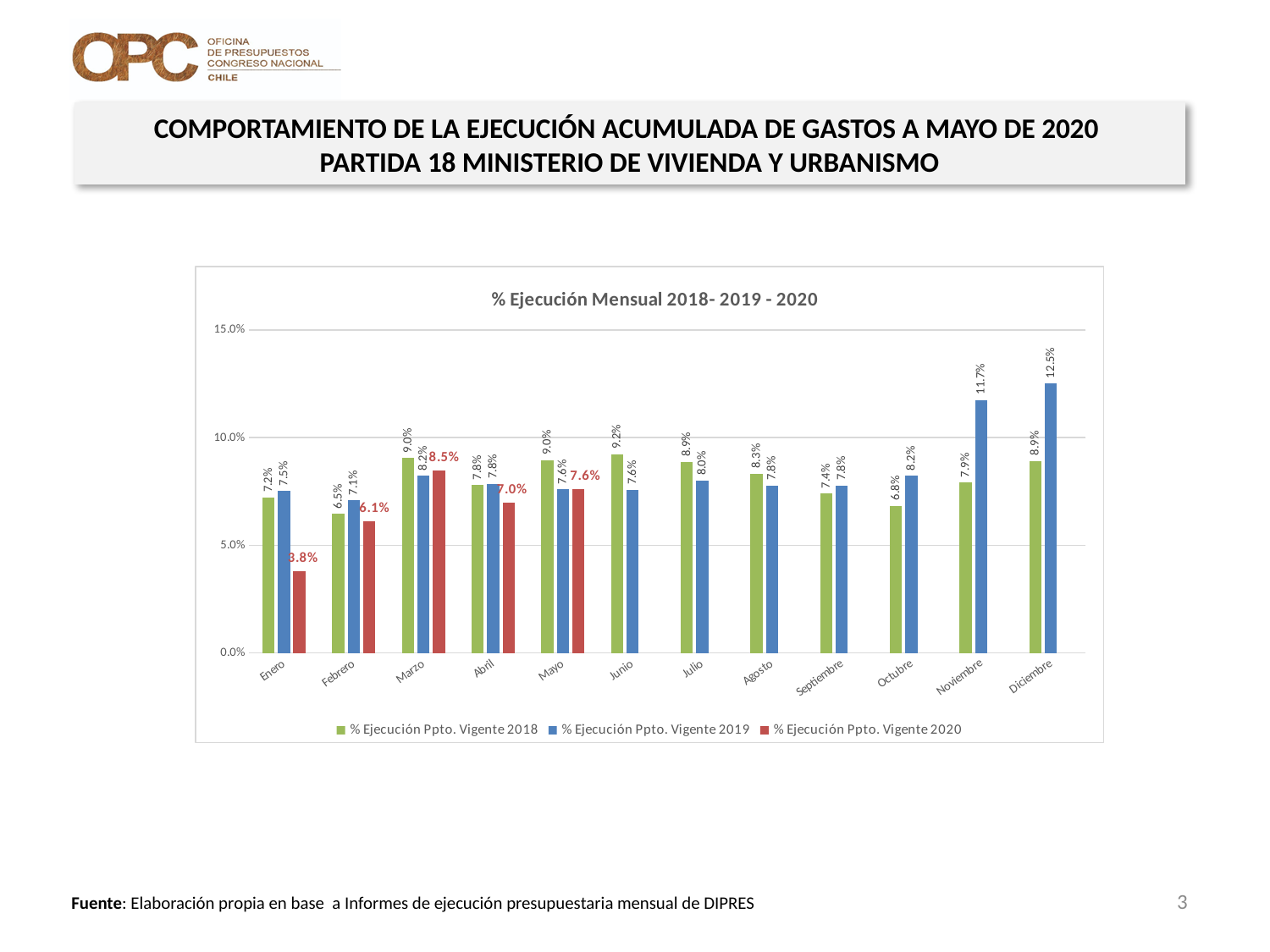
What is the value of % Ejecución Ppto. Vigente 2019 for Diciembre? 12.5% What is the value of % Ejecución Ppto. Vigente 2018 for Junio? 9.2% Which month has the highest value for % Ejecución Ppto. Vigente 2019? Diciembre How many series does the legend list? 3 What is the difference between the 2019 and 2020 values for Febrero? 1.0% Which month has the lowest value for % Ejecución Ppto. Vigente 2020? Enero What kind of chart is shown on the slide? Bar chart How many months are shown on the x axis? 12 Which is larger in Marzo: the 2018 value or the 2019 value? 2018 value (9.0%) Is the value for % Ejecución Ppto. Vigente 2019 in Noviembre greater or less than 10.0%? greater What is the title of the chart? % Ejecución Mensual 2018- 2019 - 2020 What is the value of % Ejecución Ppto. Vigente 2020 for Enero? 3.8%